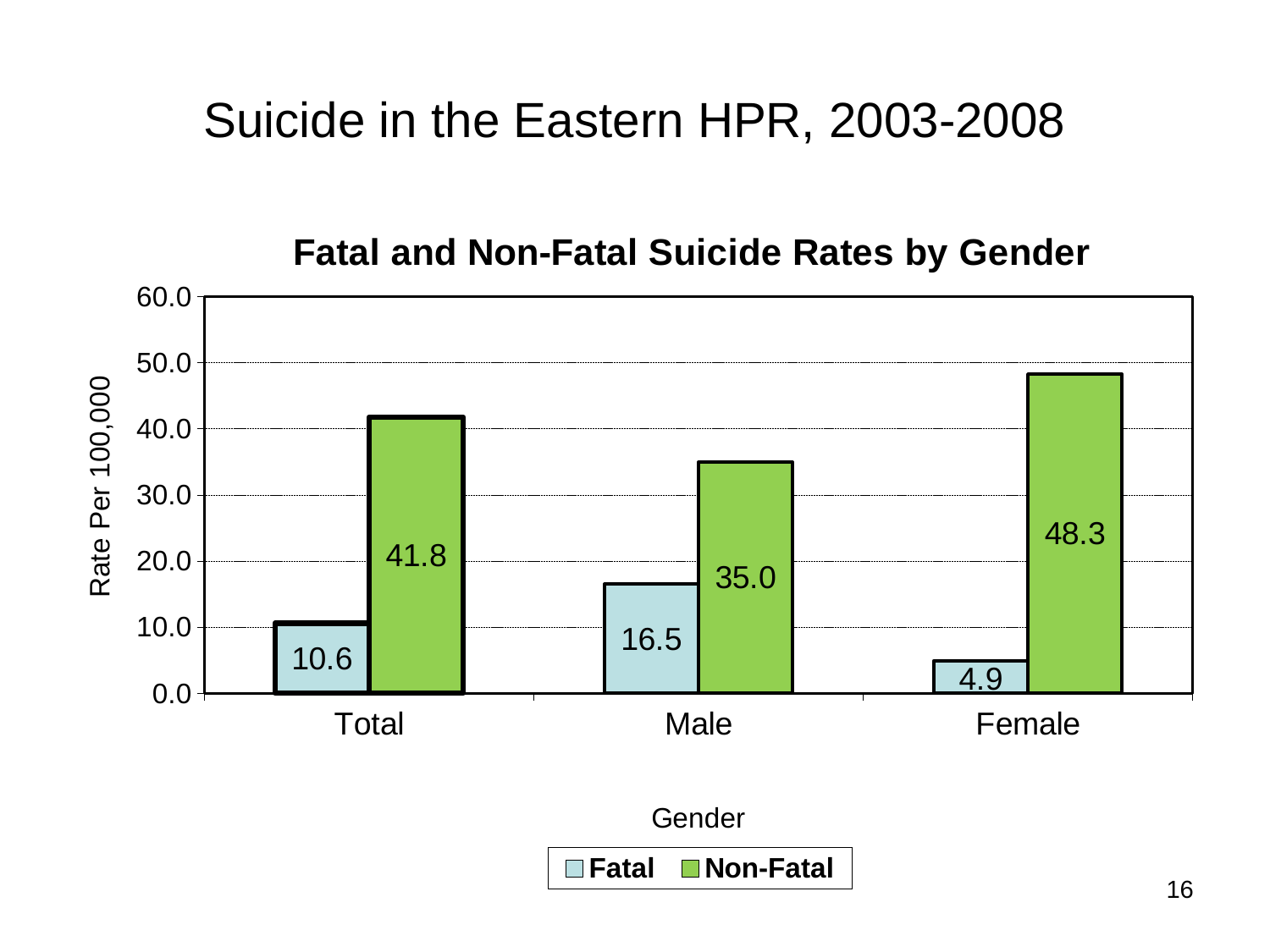
What is the Fatal suicide rate for Female? 4.9 What is the Non-Fatal suicide rate for Female? 48.3 Which is larger, the Fatal rate for Male or the Fatal rate for Total? Fatal rate for Male How many gender categories are shown on the x axis? 3 Is the Non-Fatal rate for Male greater or less than 40.0? less Which gender category has the lowest Fatal suicide rate? Female How many series does the legend list? 2 What type of chart is shown on the slide? Bar chart Which gender category has the highest Non-Fatal suicide rate? Female What is the Non-Fatal suicide rate for Total? 41.8 What is the Fatal suicide rate for Male? 16.5 What is the difference between the Non-Fatal and Fatal suicide rates for Male? 18.5